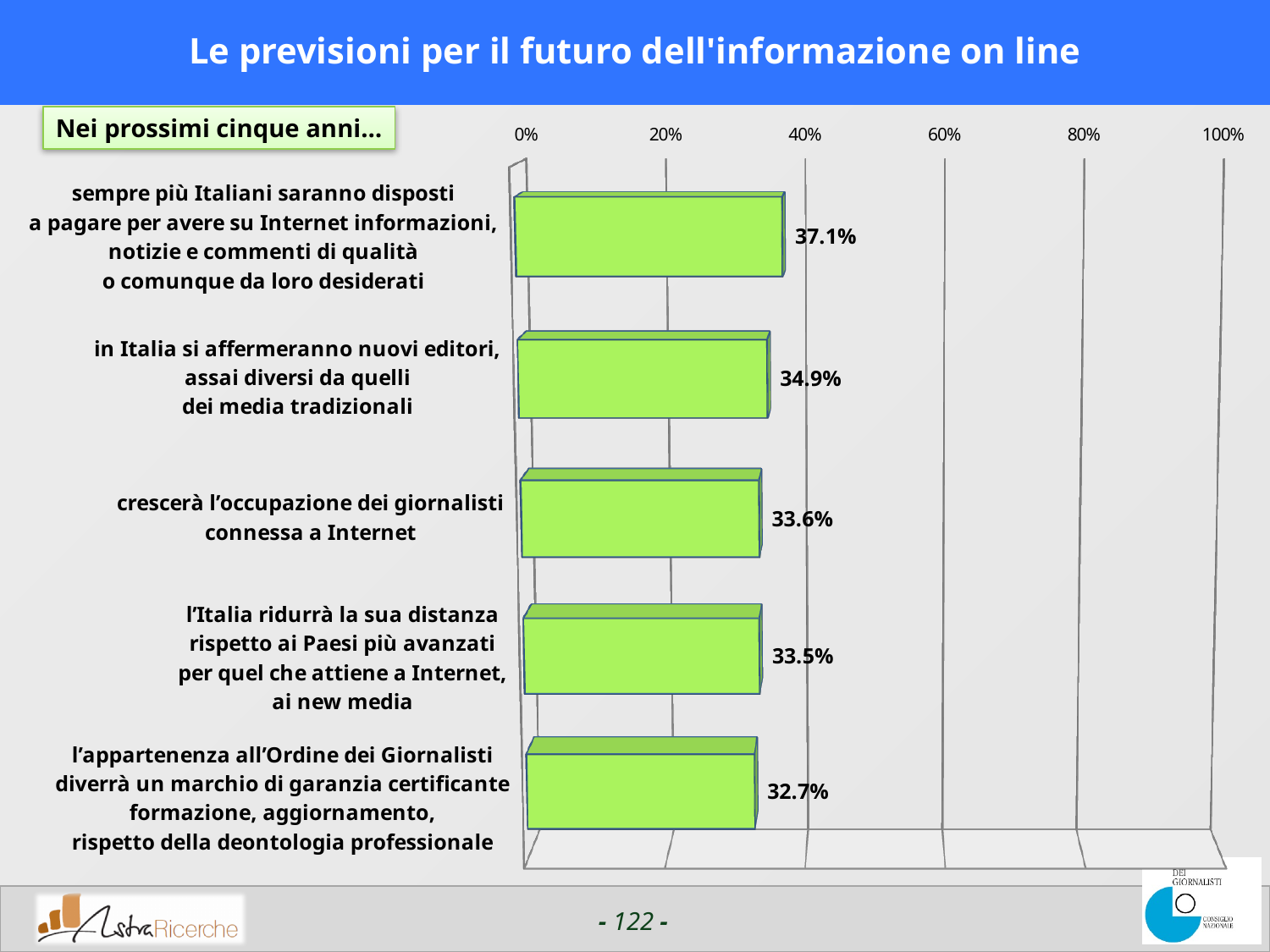
What percentage is shown for "in Italia si affermeranno nuovi editori, assai diversi da quelli dei media tradizionali"? 34.9% What is the value for "l'Italia ridurrà la sua distanza rispetto ai Paesi più avanzati per quel che attiene a Internet, ai new media"? 33.5% Is the value for "sempre più Italiani saranno disposti a pagare..." greater or less than 40%? less What is the value for "crescerà l'occupazione dei giornalisti connessa a Internet"? 33.6% Which prediction has the lowest percentage? l'appartenenza all'Ordine dei Giornalisti diverrà un marchio di garanzia certificante formazione, aggiornamento, rispetto della deontologia professionale What is the title of the slide? Le previsioni per il futuro dell'informazione on line What is the value for "l'appartenenza all'Ordine dei Giornalisti diverrà un marchio di garanzia certificante formazione, aggiornamento, rispetto della deontologia professionale"? 32.7% Which is larger: the value for "sempre più Italiani saranno disposti a pagare..." or the value for "in Italia si affermeranno nuovi editori..."? sempre più Italiani saranno disposti a pagare... How many categories (predictions) are plotted in the chart? 5 Which prediction has the highest percentage? sempre più Italiani saranno disposti a pagare per avere su Internet informazioni, notizie e commenti di qualità o comunque da loro desiderati What is the difference between the highest value (37.1%) and the lowest value (32.7%)? 4.4% What kind of chart is shown on the slide? bar chart